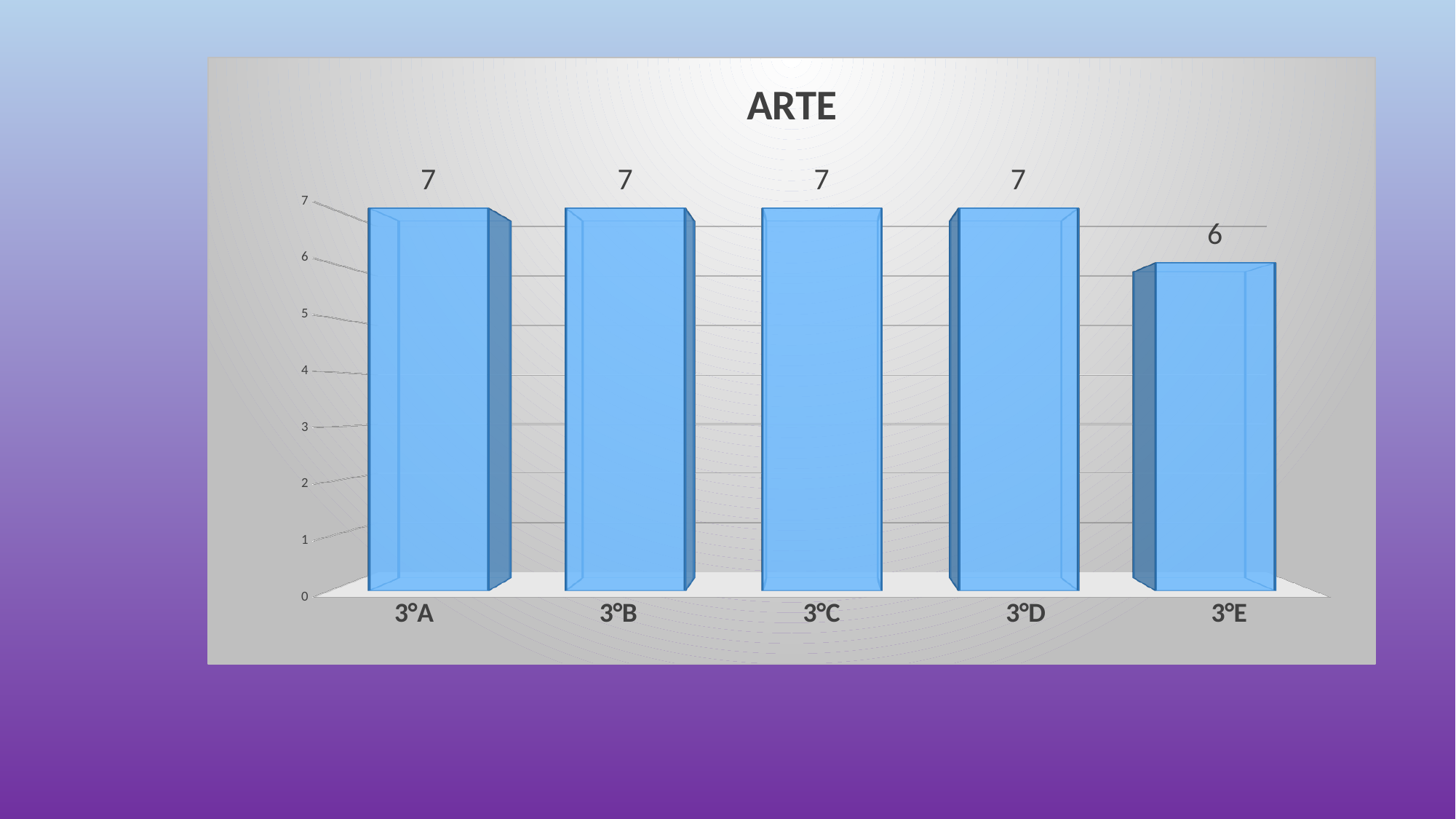
Which category has the lowest value? 3°E What is the title of the chart? ARTE What is the value for 3°A? 7 Is the value for 3°E greater or less than 7? less How many categories are shown on the x axis? 5 What kind of chart is shown? bar chart What is the value for 3°C? 7 Which is larger, the value for 3°B or the value for 3°E? 3°B How many categories have a value of 7? 4 What is the value for 3°E? 6 What is the highest value shown on the vertical axis? 7 What is the difference between the values for 3°D and 3°E? 1